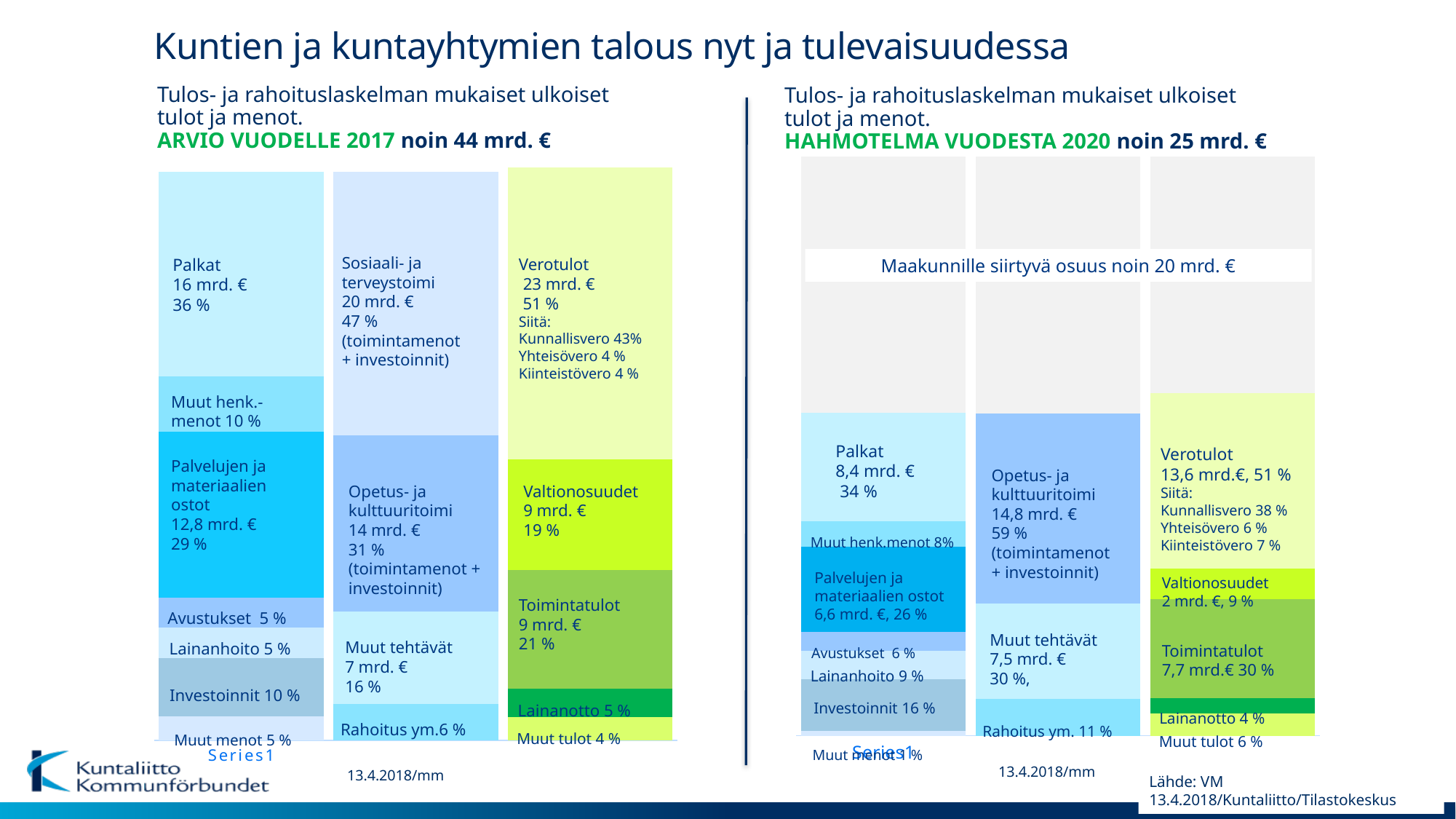
In the left chart (ARVIO VUODELLE 2017), what percentage share do Verotulot have? 51 % In the right chart (HAHMOTELMA VUODESTA 2020), which is larger in mrd. €: Toimintatulot or Valtionosuudet? Toimintatulot In the left chart (ARVIO VUODELLE 2017), which is larger in mrd. €: Sosiaali- ja terveystoimi or Opetus- ja kulttuuritoimi? Sosiaali- ja terveystoimi In the right chart (HAHMOTELMA VUODESTA 2020), what percentage share do Investoinnit have? 16 % What kind of chart is shown on the left side of the slide? Stacked bar chart In the left chart (ARVIO VUODELLE 2017), what is the value of Sosiaali- ja terveystoimi in mrd. €? 20 mrd. € In the right chart (HAHMOTELMA VUODESTA 2020), what is the value of Opetus- ja kulttuuritoimi in mrd. €? 14,8 mrd. € In the right chart (HAHMOTELMA VUODESTA 2020), what is the Kunnallisvero share listed under Verotulot? 38 % What is the difference in mrd. € between Palkat in the left chart (16 mrd. €) and Palkat in the right chart (8,4 mrd. €)? 7,6 mrd. € In the left chart (ARVIO VUODELLE 2017), what is the difference in mrd. € between Verotulot and Valtionosuudet? 14 mrd. € According to the right chart (HAHMOTELMA VUODESTA 2020), how many mrd. € is the share transferring to the regions (Maakunnille siirtyvä osuus)? noin 20 mrd. € In the left chart (ARVIO VUODELLE 2017), how many mrd. € are Palkat? 16 mrd. €